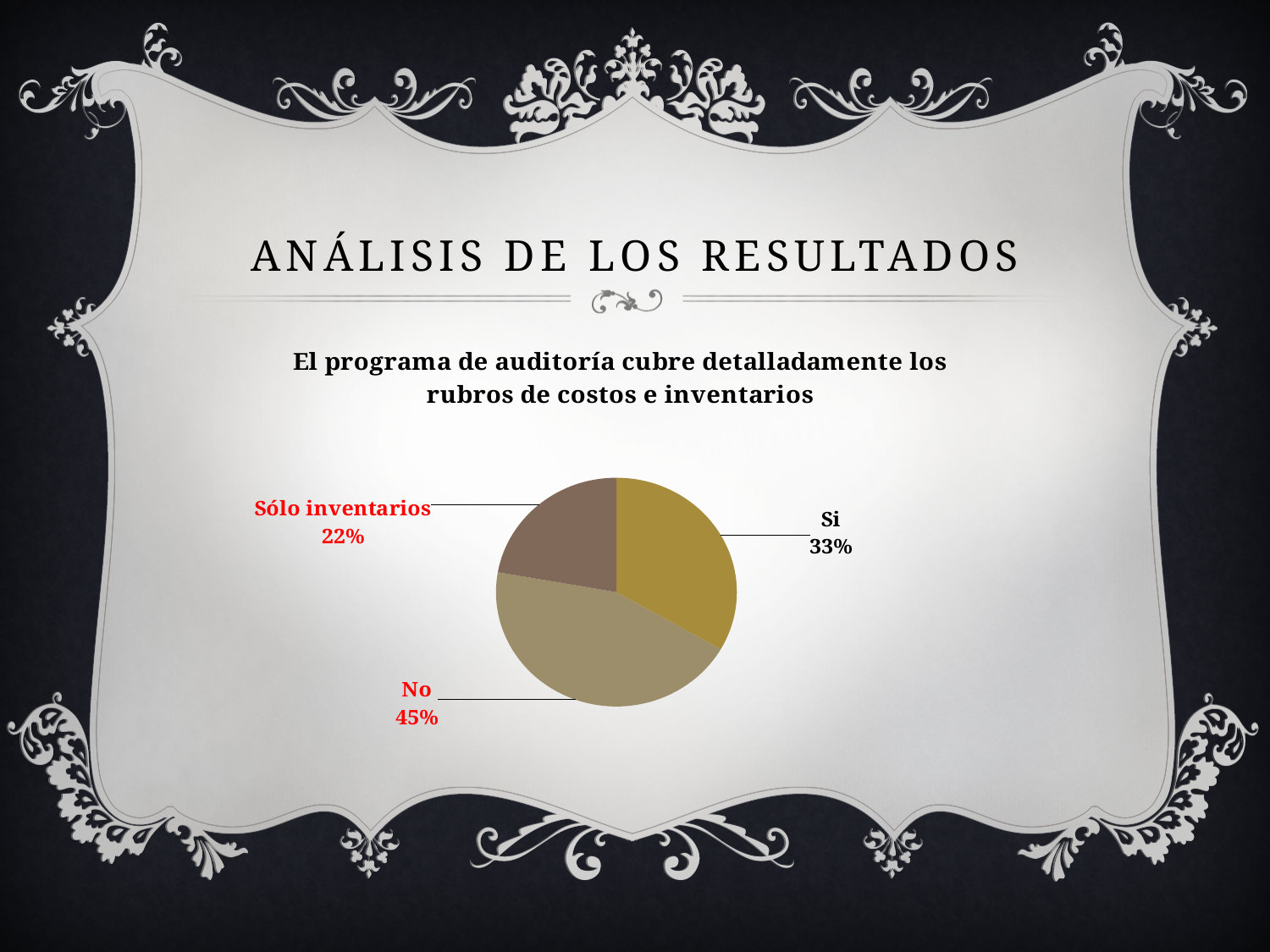
What is the title of the chart? El programa de auditoría cubre detalladamente los rubros de costos e inventarios What is the value for the "No" slice? 45% What is the difference between the "Si" and "Sólo inventarios" slices? 11% Which is larger, the "Si" slice or the "Sólo inventarios" slice? Si Which slice is the smallest? Sólo inventarios How many slices does the pie chart have? 3 Which slice is the largest? No What is the value for the "Sólo inventarios" slice? 22% What is the value for the "Si" slice? 33% What share of the pie does the "No" slice represent? 45% What is the difference between the "No" and "Si" slices? 12% What type of chart is shown on the slide? pie chart